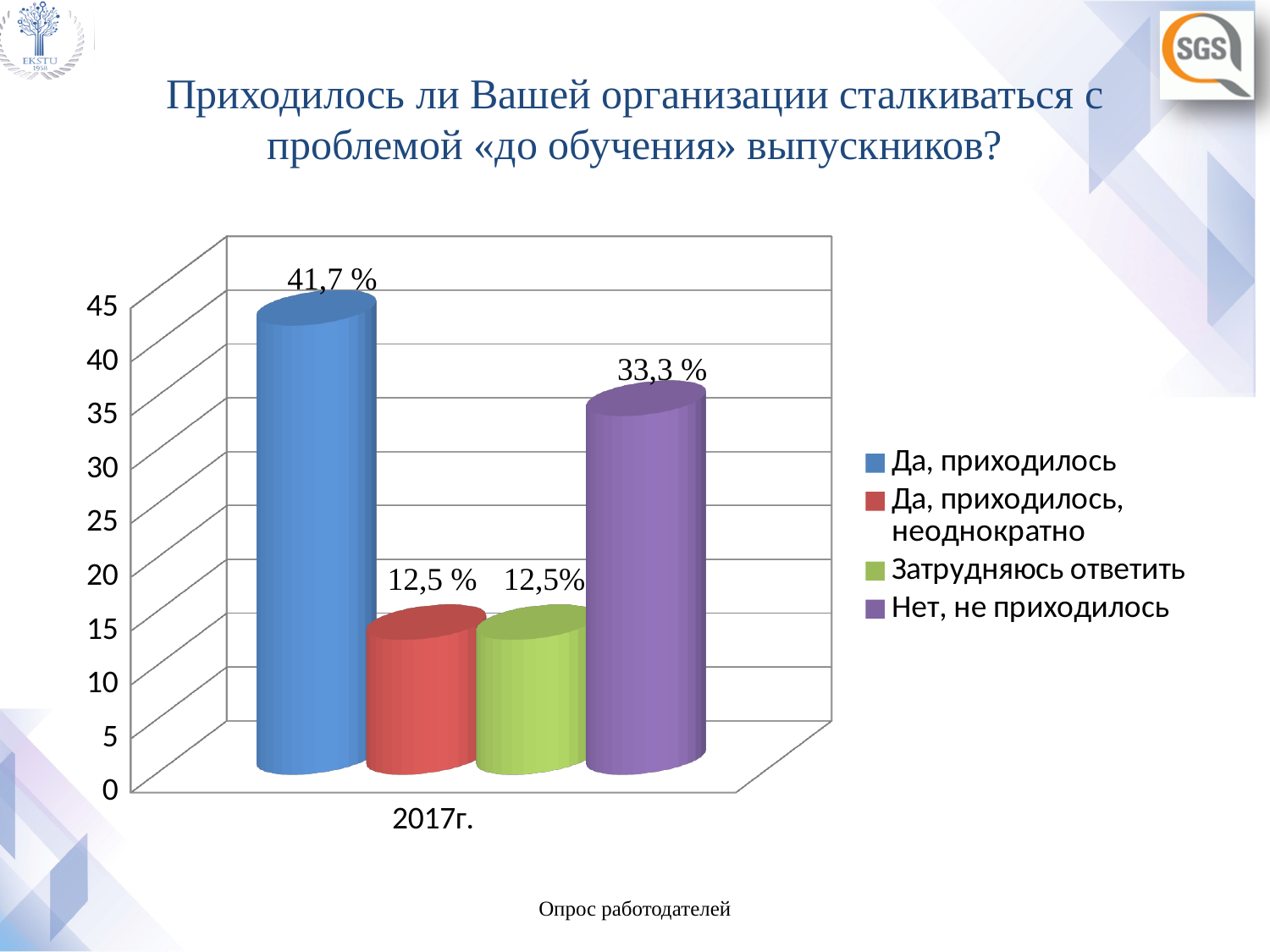
What value is shown for "Да, приходилось, неоднократно"? 12,5 % Which response has the highest value? Да, приходилось Is the value for "Нет, не приходилось" greater or less than 30? greater What value is shown for "Нет, не приходилось"? 33,3 % Which is larger, the value for "Нет, не приходилось" or the value for "Да, приходилось, неоднократно"? Нет, не приходилось What value is shown for "Да, приходилось"? 41,7 % What value is shown for "Затрудняюсь ответить"? 12,5% What kind of chart is shown on the slide? bar chart What is the difference between the values for "Да, приходилось" and "Нет, не приходилось"? 8,4 % What year label appears on the x axis of the chart? 2017г. How many series does the legend list? 4 What is the difference between the values for "Нет, не приходилось" and "Затрудняюсь ответить"? 20,8 %